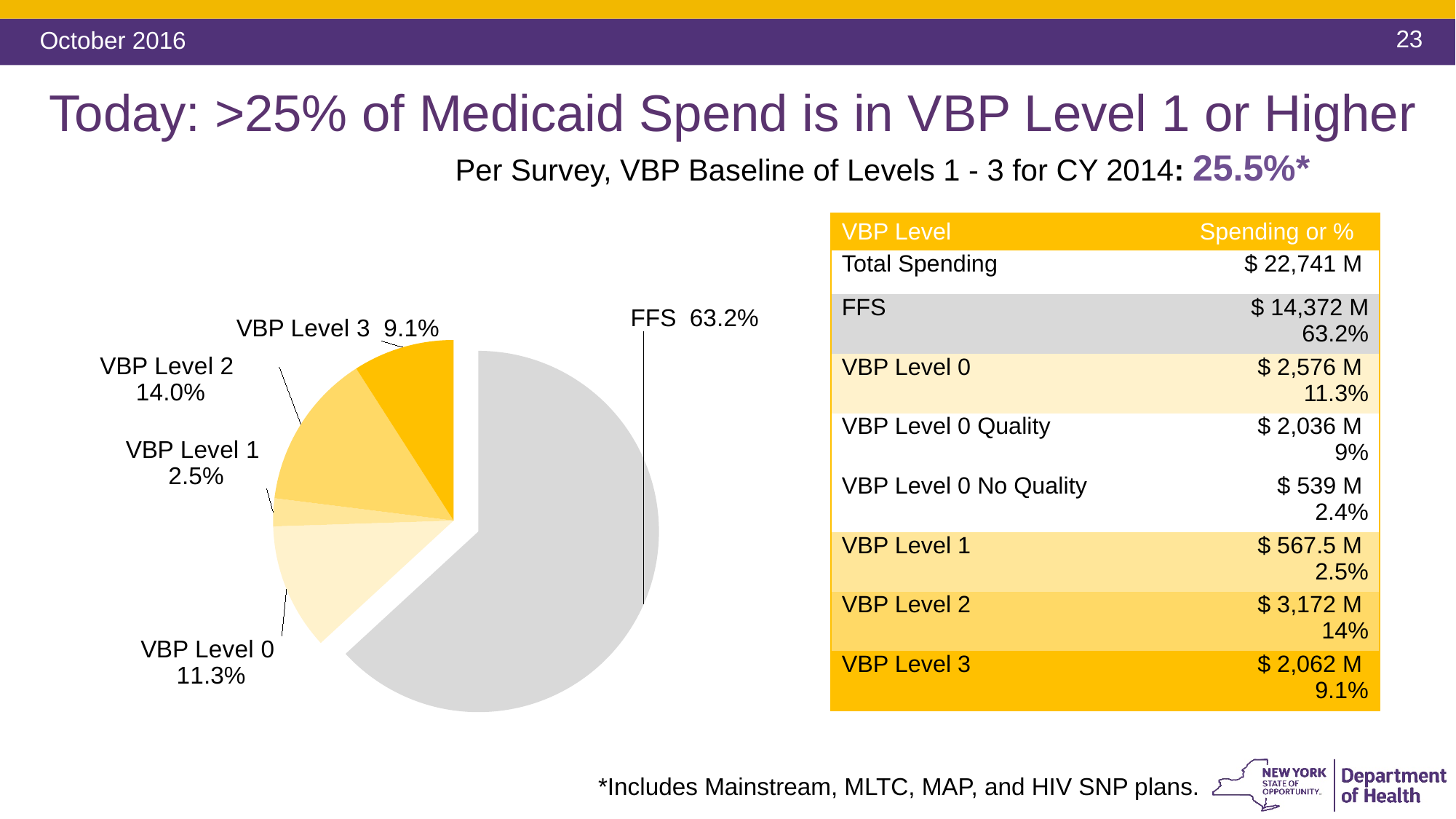
Which slice of the pie chart is the largest? FFS What type of chart is shown on the slide? Pie chart Which slice of the pie chart is the smallest? VBP Level 1 How many slices does the pie chart have? 5 What share of the pie chart does FFS represent? 63.2% Which slice is larger, VBP Level 0 or VBP Level 3? VBP Level 0 What share of the pie chart does VBP Level 2 represent? 14.0% What share of the pie chart does VBP Level 0 represent? 11.3% Which slice of the pie chart is pulled out (exploded) from the rest? FFS What is the difference in percentage points between the VBP Level 2 and VBP Level 3 slices? 4.9 What is the combined share of the VBP Level 1, VBP Level 2 and VBP Level 3 slices? 25.6% What share of the pie chart does VBP Level 1 represent? 2.5%